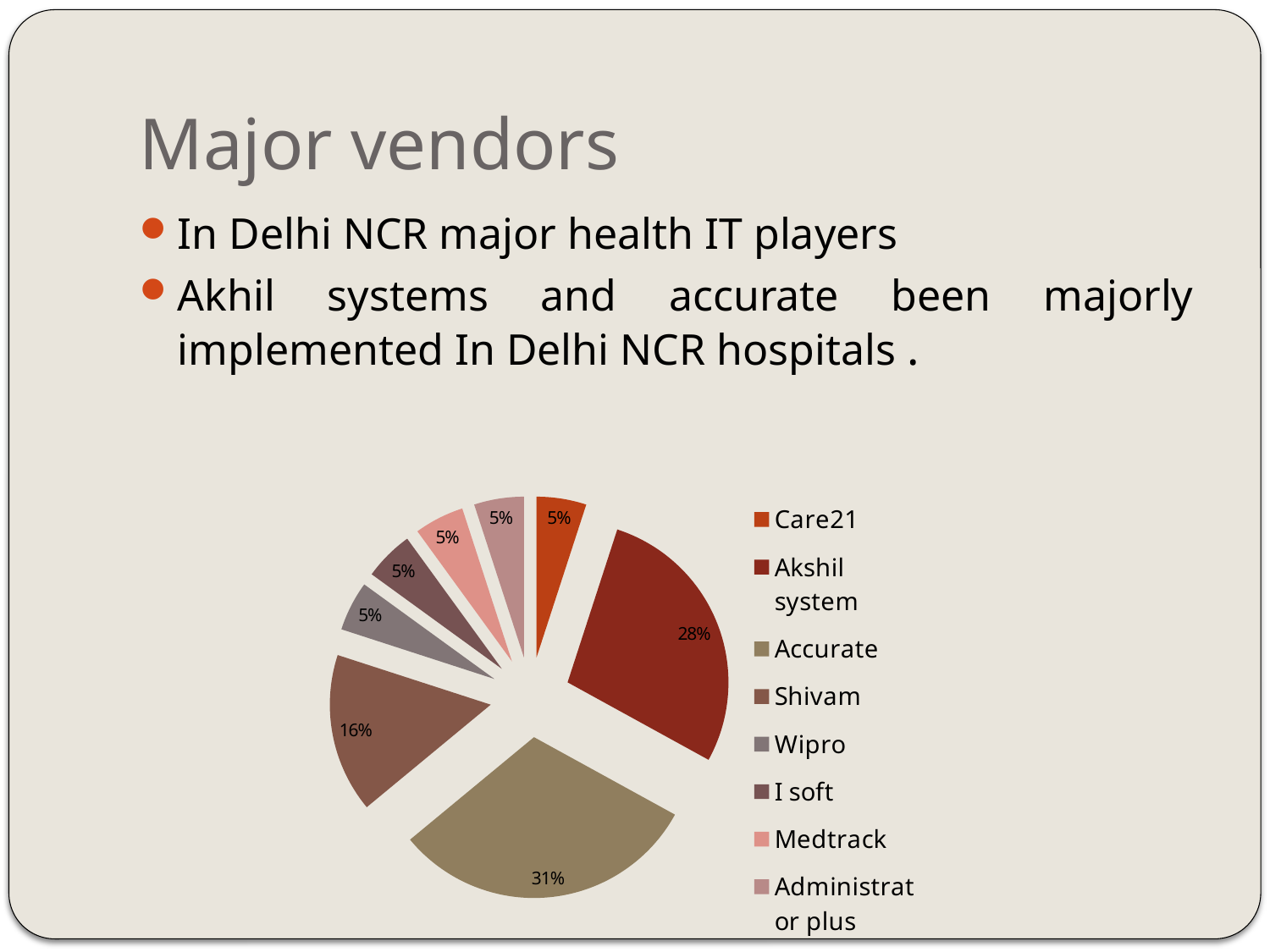
How many slices does the pie chart have? 8 What type of chart is shown on the slide? pie chart What is the difference in percentage points between Accurate and Akshil system? 3 What share of the pie does Akshil system hold? 28% What share of the pie does Shivam hold? 16% How many vendors each hold a 5% share of the pie? 5 What share of the pie does Care21 hold? 5% How many vendors are listed in the legend? 8 Which vendor has the largest slice of the pie? Accurate Which is larger, the slice for Shivam or the slice for Wipro? Shivam What share of the pie does Accurate hold? 31% What is the difference in percentage points between Akshil system and Shivam? 12